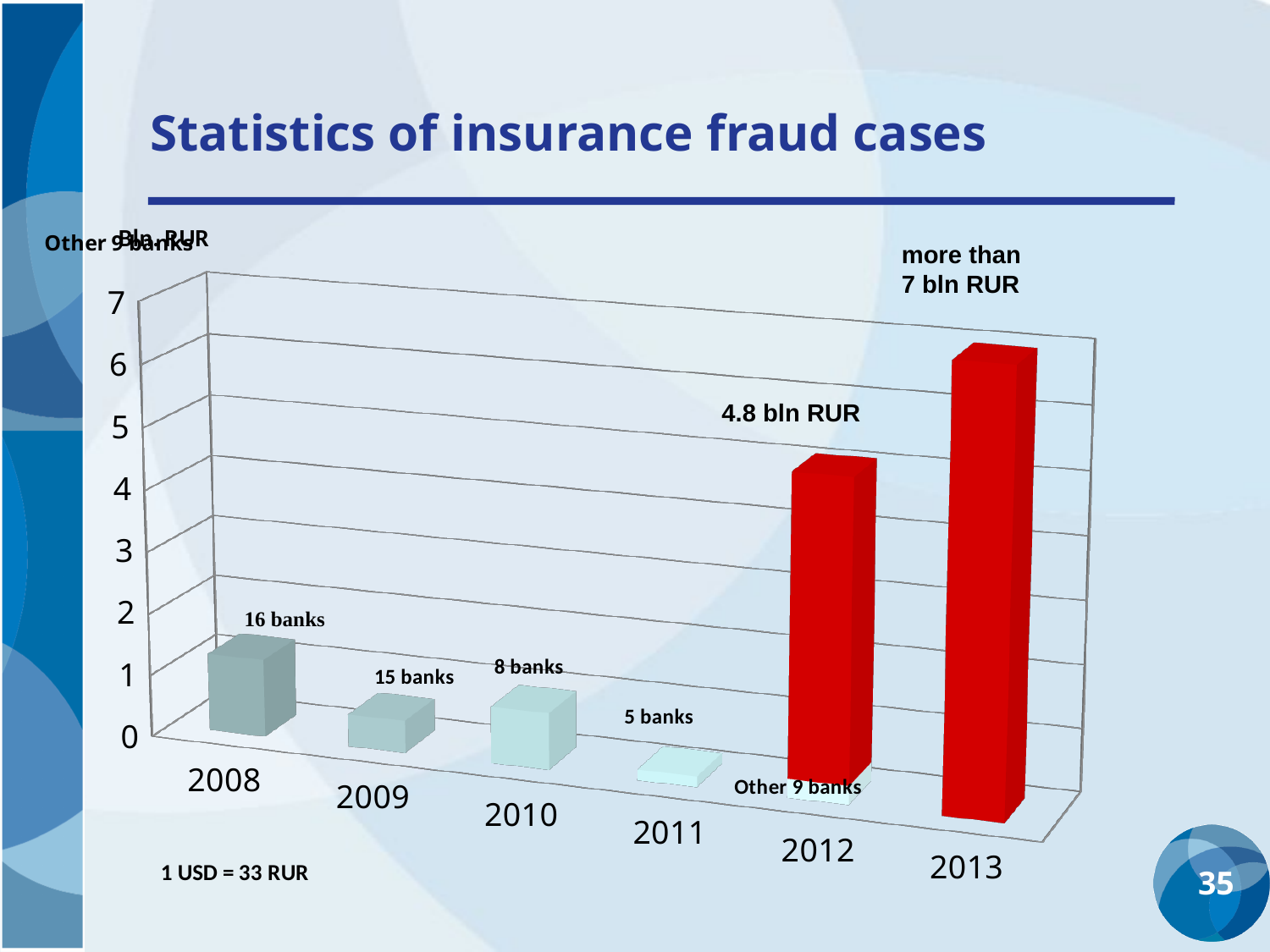
Which bar is taller, 2012 or 2013? 2013 How many banks are labelled for 2008? 16 banks Which year has the highest bar in the chart? 2013 What value is labelled on the red bar for 2012? 4.8 bln RUR How many years are shown along the x axis of the chart? 6 How many banks are labelled for 2011? 5 banks What exchange rate note is printed at the bottom of the chart? 1 USD = 33 RUR Which year has the lowest bar in the chart? 2011 What kind of chart is shown on the slide? bar chart Is the value for 2012 greater or less than 3? greater What label is given for the 2013 bar? more than 7 bln RUR